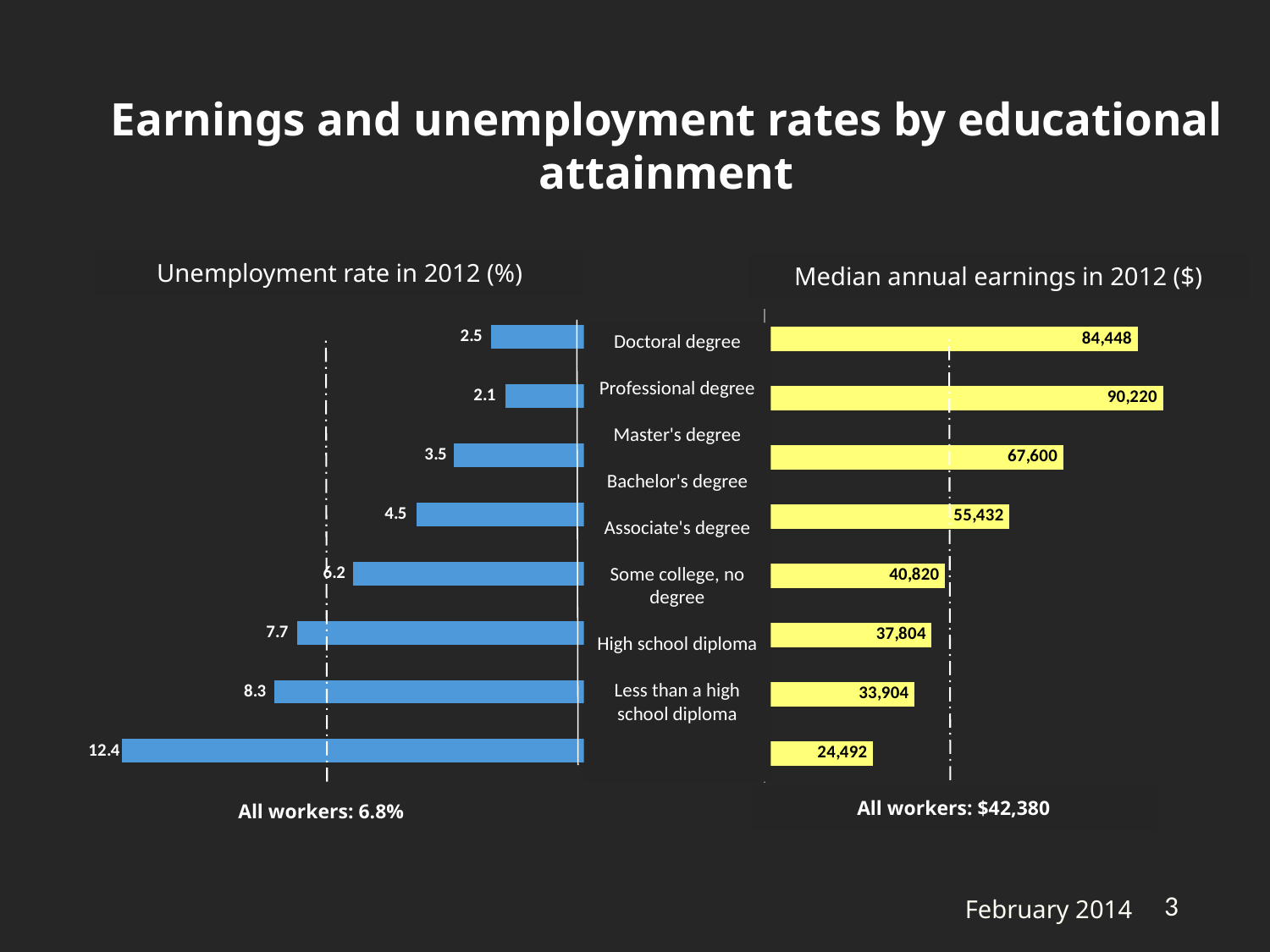
In the 'Unemployment rate in 2012 (%)' chart, what is the highest unemployment rate shown? 12.4 How many bars are in the 'Median annual earnings in 2012 ($)' chart? 8 In the 'Median annual earnings in 2012 ($)' chart, what are the median annual earnings for Professional degree? 90,220 In the 'Median annual earnings in 2012 ($)' chart, what is the difference between the earnings for Professional degree and Doctoral degree? 5,772 In the 'Unemployment rate in 2012 (%)' chart, which has the higher unemployment rate, Doctoral degree or Professional degree? Doctoral degree What unemployment rate is given for all workers on the slide? 6.8% In the 'Unemployment rate in 2012 (%)' chart, what is the lowest unemployment rate shown? 2.1 In the 'Median annual earnings in 2012 ($)' chart, what are the median annual earnings for Doctoral degree? 84,448 In the 'Median annual earnings in 2012 ($)' chart, what is the lowest value shown? 24,492 What median annual earnings figure is given for all workers on the slide? $42,380 What kind of chart is the 'Unemployment rate in 2012 (%)' chart? bar chart In the 'Unemployment rate in 2012 (%)' chart, what is the unemployment rate for Doctoral degree? 2.5